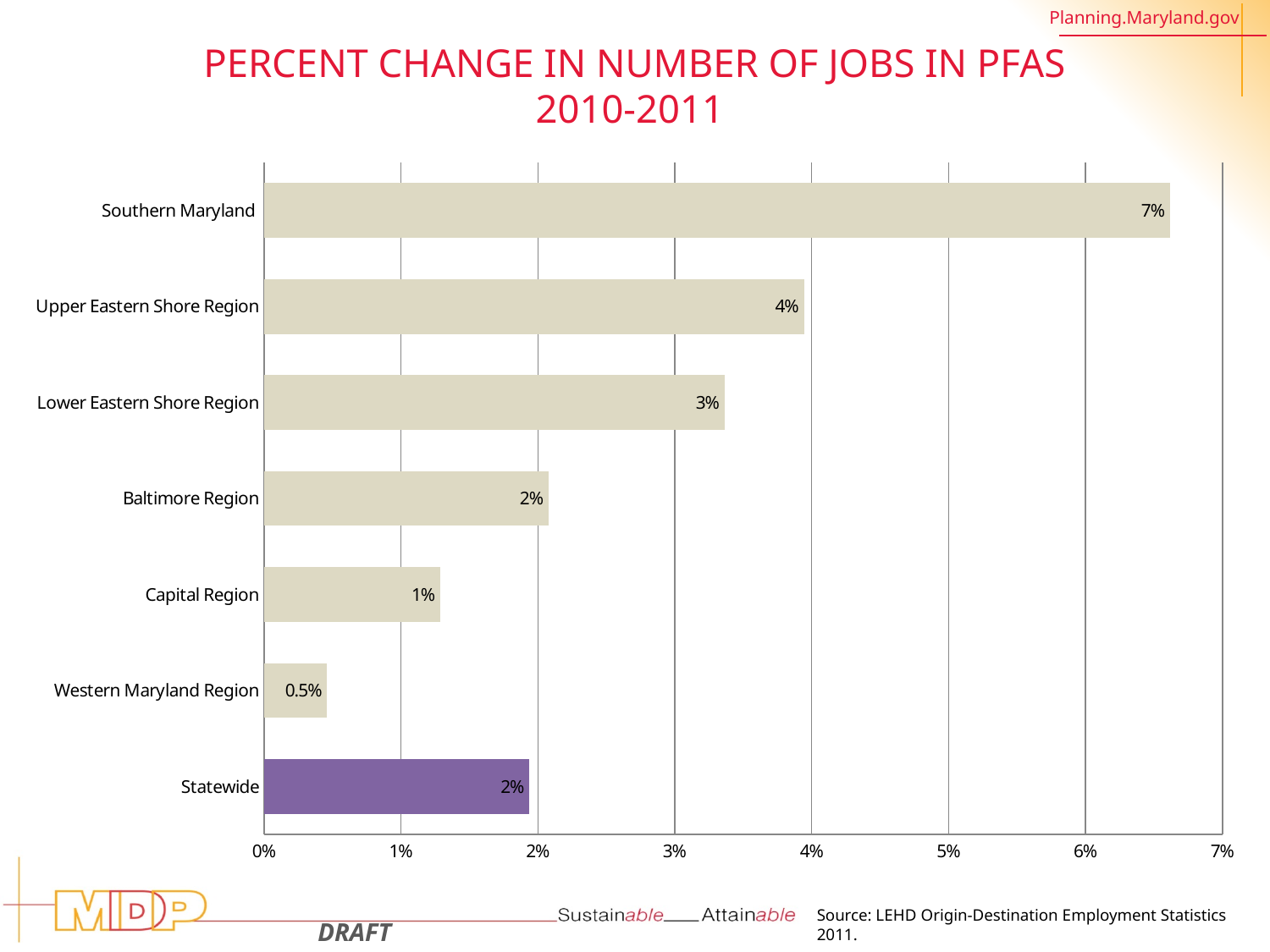
Which region has the highest percent change in number of jobs? Southern Maryland How many categories are shown in the chart? 7 What is the percent change in number of jobs for the Lower Eastern Shore Region? 3% What is the percent change in number of jobs for the Western Maryland Region? 0.5% Is the value for the Western Maryland Region greater or less than 1%? less What is the Statewide percent change in number of jobs? 2% Which region has the lowest percent change in number of jobs? Western Maryland Region What type of chart is shown on the slide? Bar chart What is the percent change in number of jobs for the Upper Eastern Shore Region? 4% What is the percent change in number of jobs for Southern Maryland? 7% Is the value for Southern Maryland greater or less than 6%? greater Which has a larger percent change, the Upper Eastern Shore Region or the Capital Region? Upper Eastern Shore Region